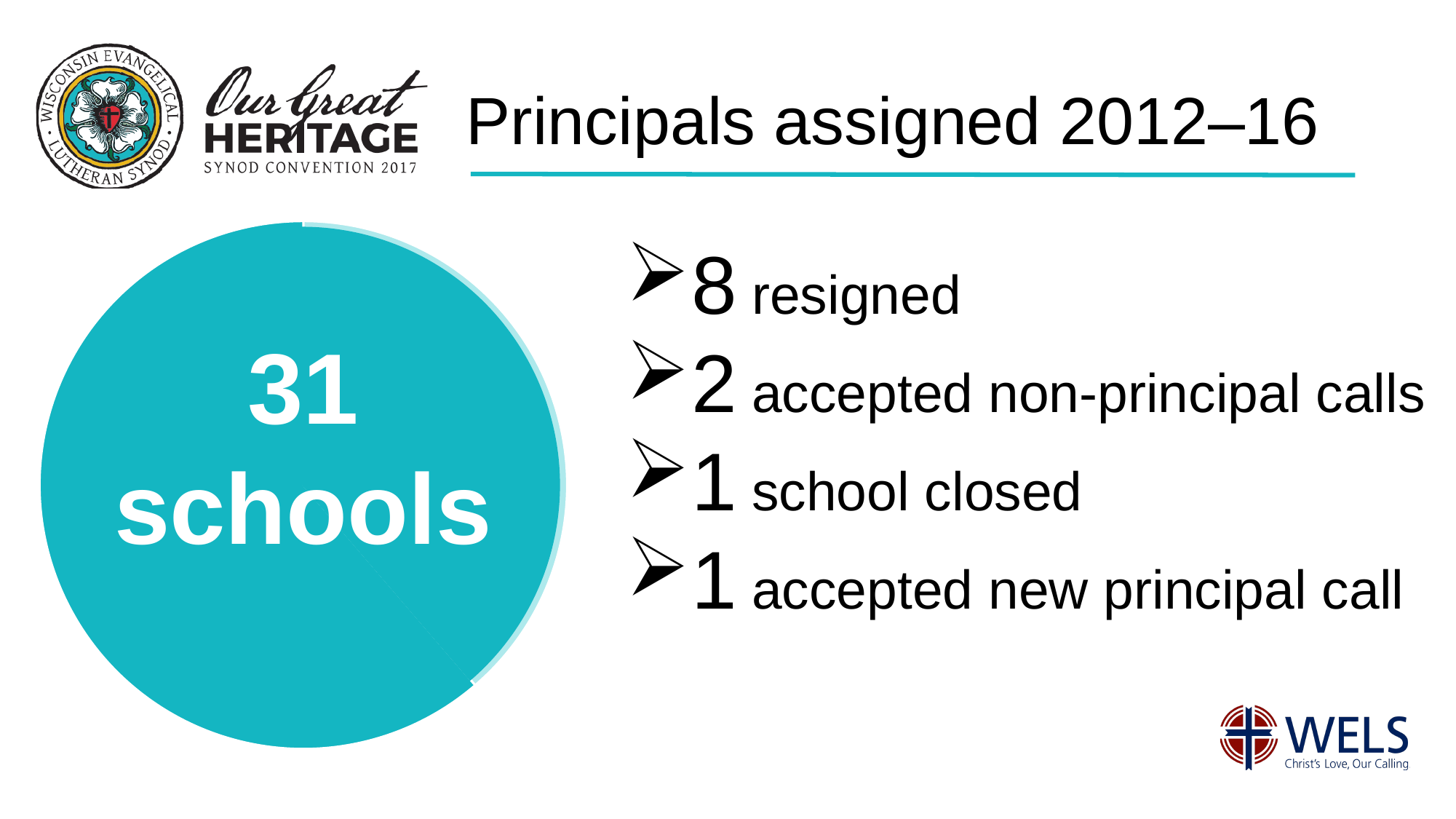
What label is printed inside the circle chart on the left of the slide? 31 schools What is the title of the slide containing the circle chart? Principals assigned 2012–16 What colour is the circle chart on the left of the slide? teal What kind of chart is shown on the left of the slide? pie chart How many schools does the circle chart on the left of the slide show? 31